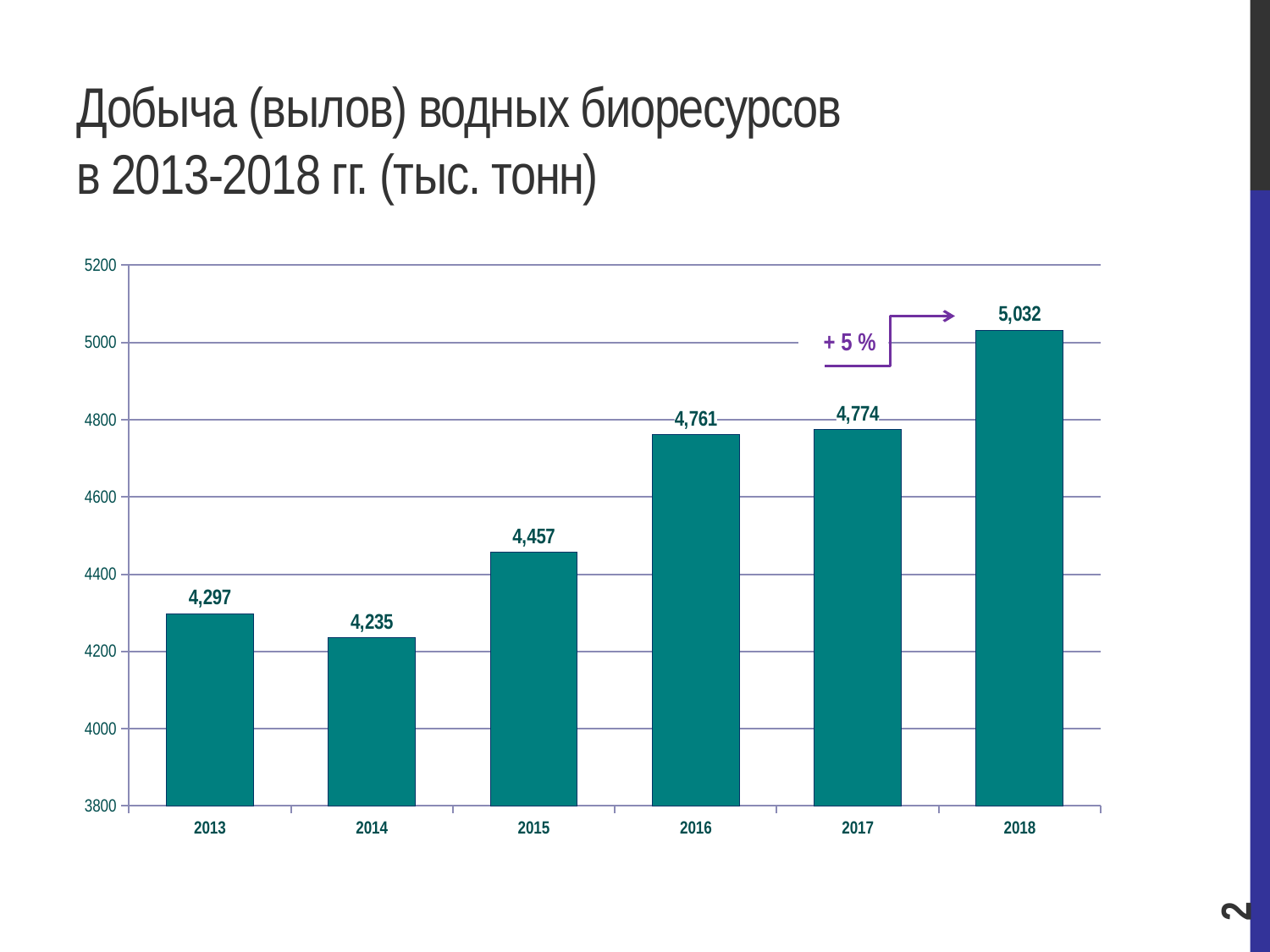
Which is larger, the value for 2013 or the value for 2014? 2013 What is the difference between the values for 2018 and 2017? 258 Is the value for 2018 greater or less than 5000? greater What is the difference between the values for 2015 and 2014? 222 How many years are shown on the x axis? 6 Which year has the lowest value? 2014 What is the value for 2018? 5,032 What is the value for 2016? 4,761 Which year has the highest value? 2018 What is the value for 2013? 4,297 What percentage change is annotated between 2017 and 2018? + 5 % What kind of chart is shown on the slide? bar chart